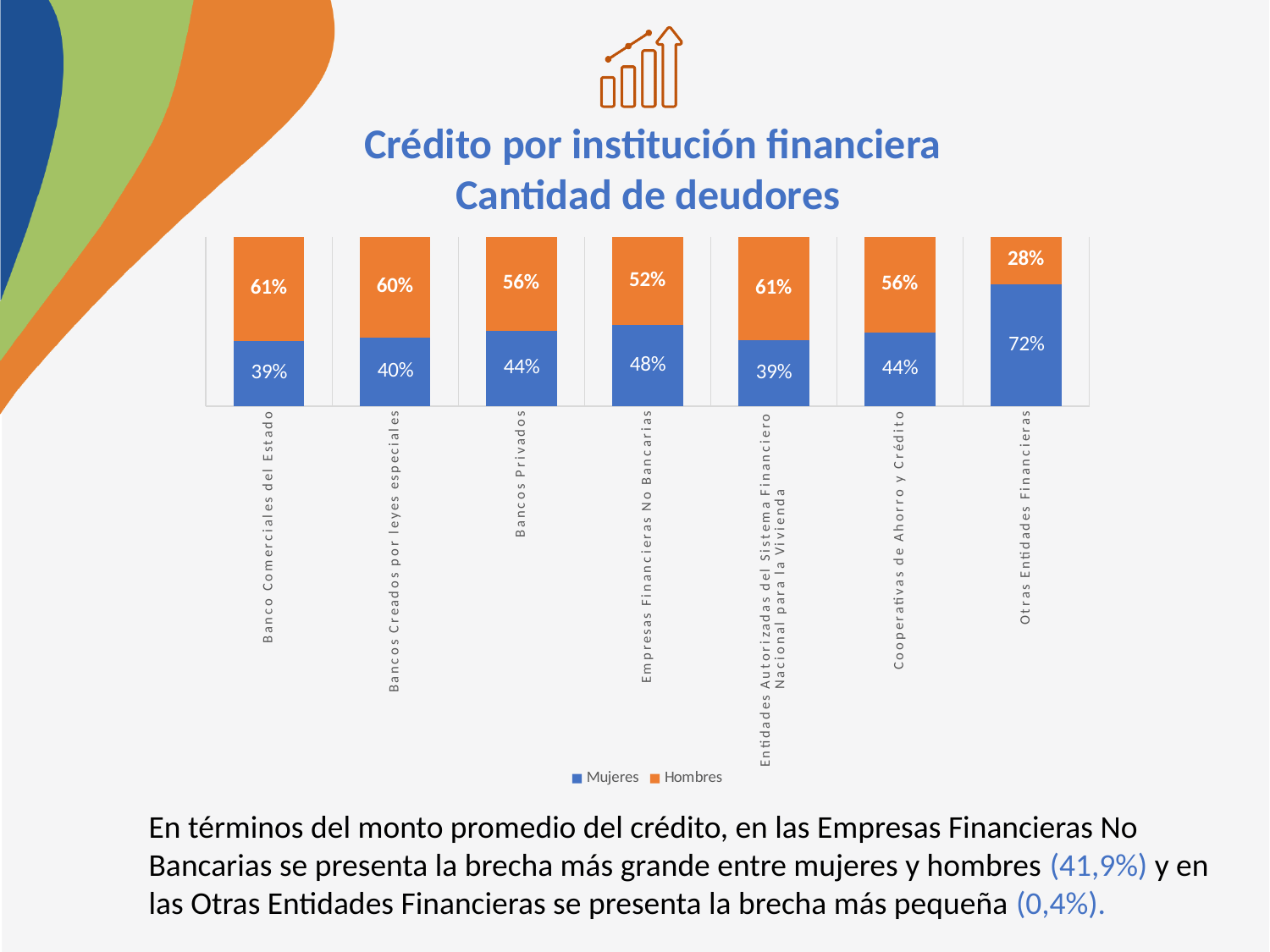
What is the Hombres value for Banco Comerciales del Estado? 61% What is the Hombres value for Empresas Financieras No Bancarias? 52% Which category has the highest Mujeres value? Otras Entidades Financieras Which is larger for Cooperativas de Ahorro y Crédito, the Mujeres value or the Hombres value? Hombres What is the total of the stacked bar for Bancos Creados por leyes especiales? 100% What is the difference between the Mujeres and Hombres values for Otras Entidades Financieras? 44 percentage points How many categories are shown on the x axis? 7 What kind of chart is shown? Stacked bar chart Which category has the lowest Hombres value? Otras Entidades Financieras What is the Mujeres value for Otras Entidades Financieras? 72% What is the Mujeres value for Bancos Privados? 44% How many series does the legend list? 2